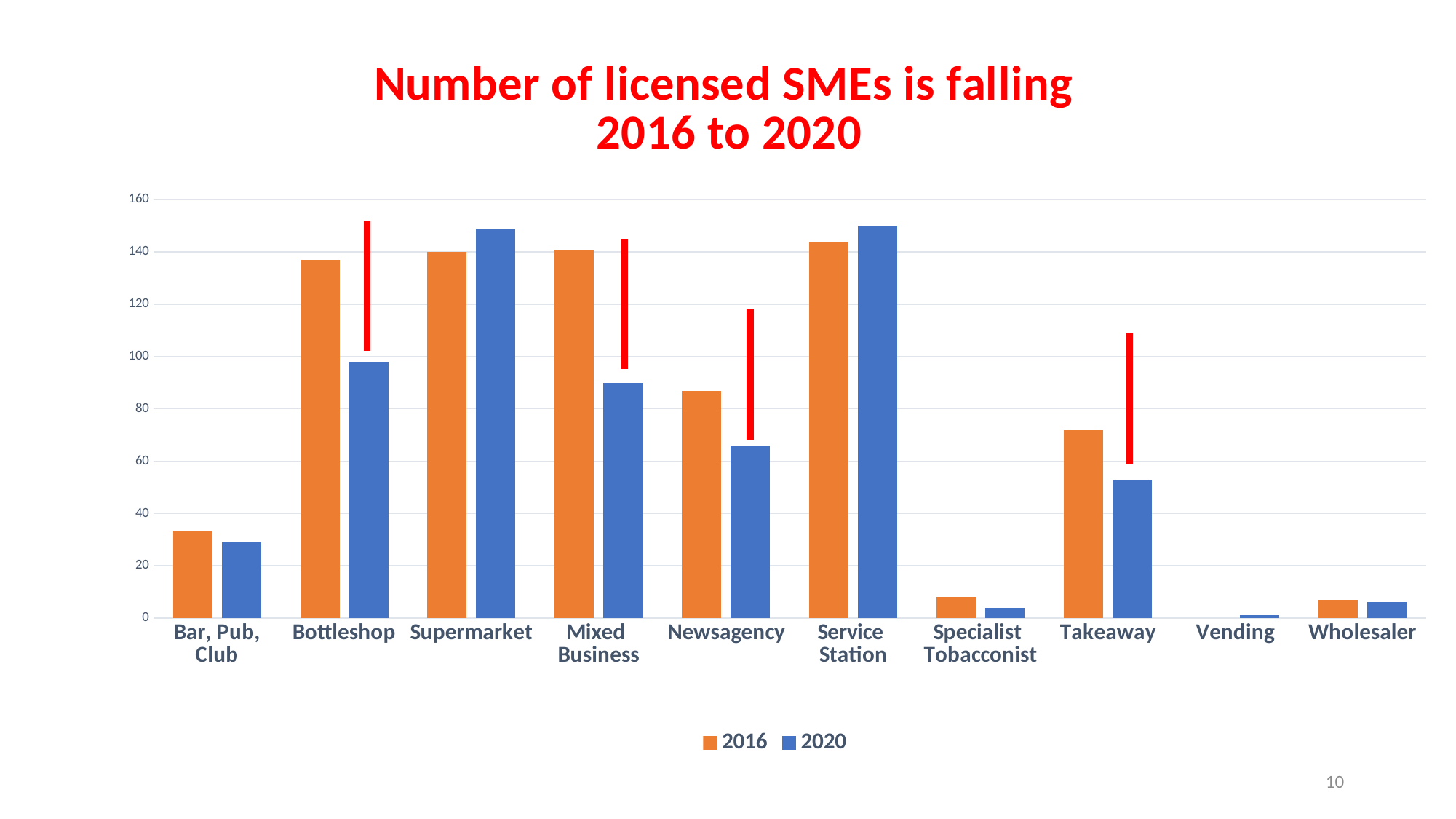
Which category has the lowest value for 2020? Vending Which colour represents the 2020 series in the legend? blue Is the 2020 value for Service Station greater or less than 140? greater For Supermarket, which is larger, the 2016 value or the 2020 value? 2020 For Takeaway, which is larger, the 2016 value or the 2020 value? 2016 Is the 2016 value for Specialist Tobacconist greater or less than 20? less Is the 2020 value for Newsagency greater or less than 60? greater How many categories are shown on the x axis? 10 What kind of chart is shown on the slide? bar chart How many series does the legend list? 2 For Bottleshop, which is larger, the 2016 value or the 2020 value? 2016 What is the title of the chart? Number of licensed SMEs is falling 2016 to 2020